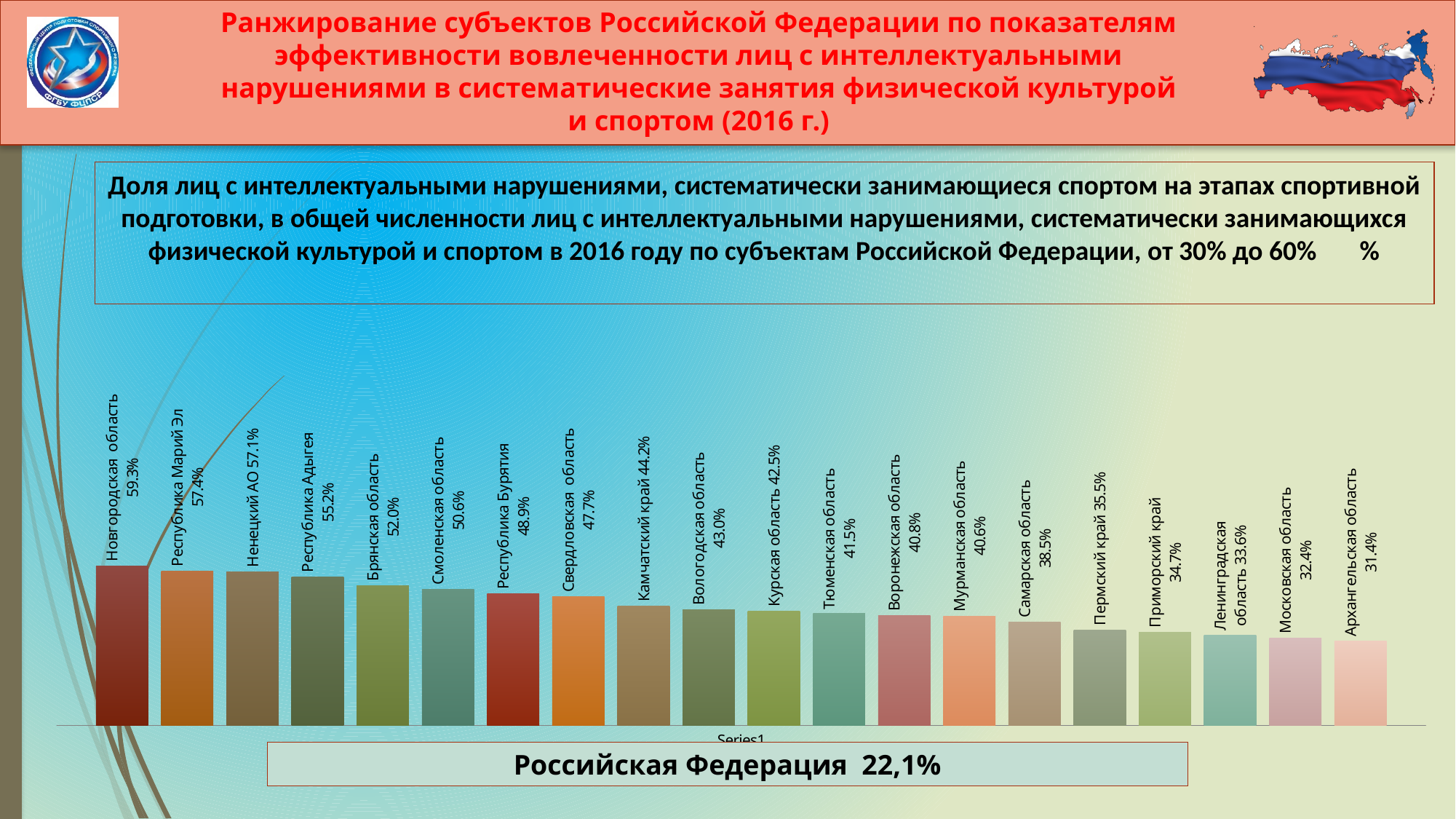
What is the value for Приморский край? 34.7% Which region has the lowest value on the chart? Архангельская область Which has a larger value, Вологодская область or Курская область? Вологодская область What is the difference between the values for Новгородская область and Архангельская область? 27.9% What kind of chart is shown on the slide? bar chart How many regions (bars) are shown on the chart? 20 What is the value for Новгородская область? 59.3% What is the difference between the values for Брянская область and Смоленская область? 1.4% What is the value for Камчатский край? 44.2% Do the values rise or fall from left to right along the x axis? fall Which region has the highest value on the chart? Новгородская область Which has a larger value, Республика Бурятия or Свердловская область? Республика Бурятия